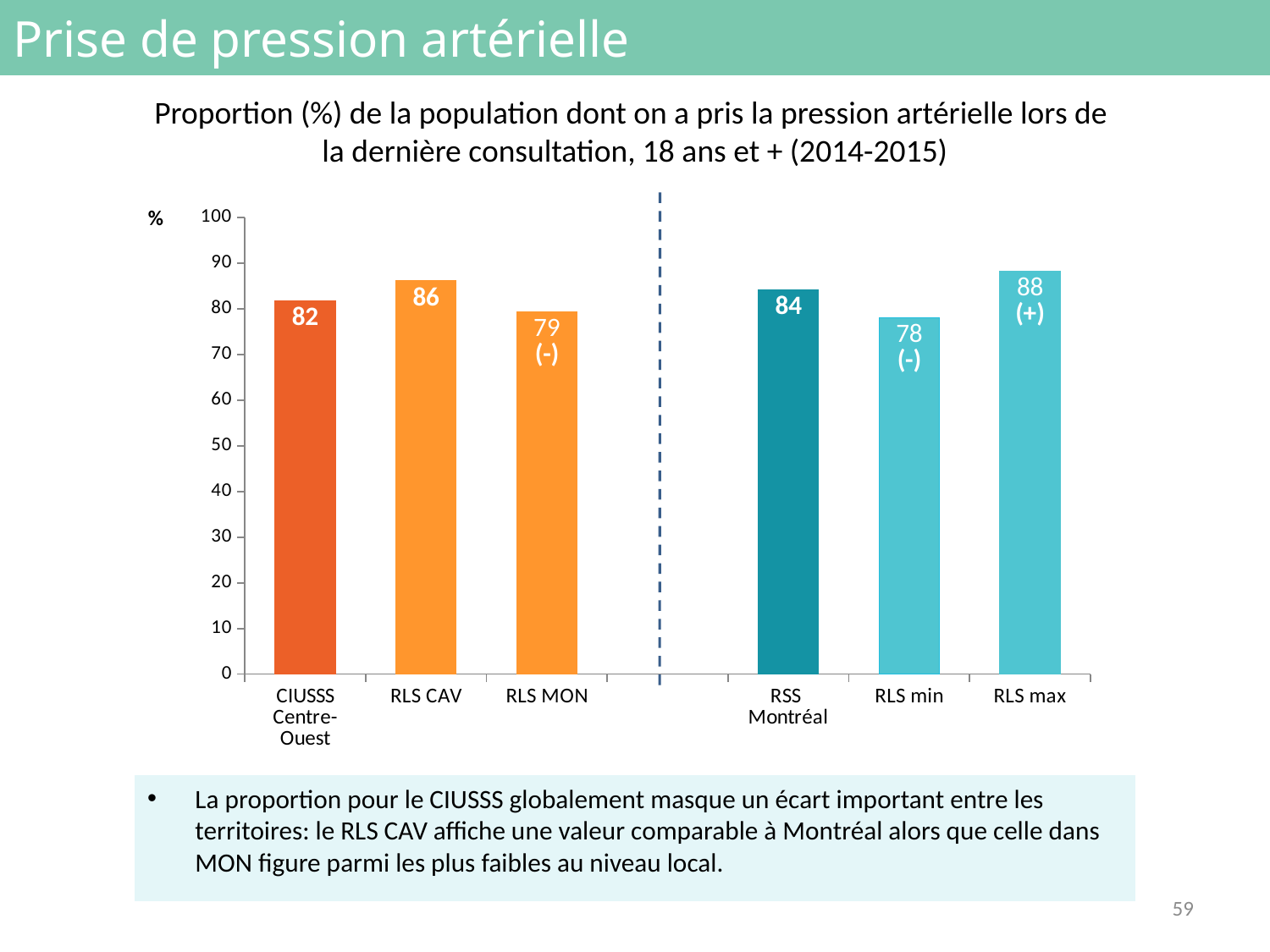
How many categories are shown on the x axis? 6 Which category has the lowest value? RLS min What is the difference between the values for RLS CAV and RLS MON? 7 Which category has the highest value? RLS max What is the value for RLS max? 88 What is the value for RSS Montréal? 84 What kind of chart is shown on the slide? bar chart Which is larger, the value for RLS CAV or the value for RSS Montréal? RLS CAV What is the value for CIUSSS Centre-Ouest? 82 What is the value for RLS MON? 79 Is the value for RLS min greater or less than 80? less What is the value for RLS CAV? 86